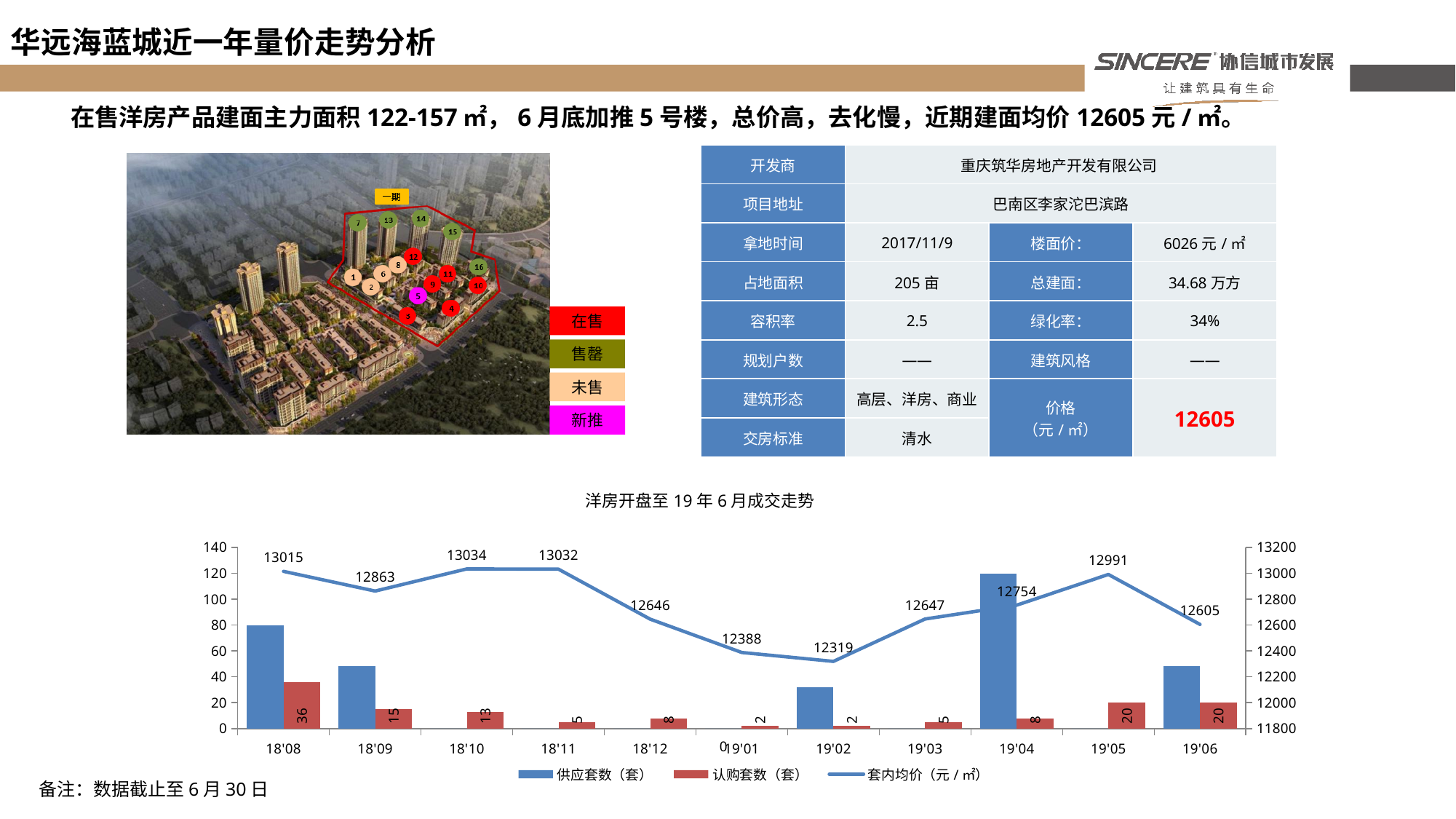
How many months are shown on the x axis of the chart? 11 Does the 套内均价（元/㎡） rise or fall from 19'02 to 19'05? rise How many series does the chart legend list? 3 Is the 供应套数（套） value for 19'04 greater or less than 100? greater Which month has a larger 认购套数（套）, 18'09 or 18'10? 18'09 Is the 供应套数（套） value for 18'08 greater or less than 60? greater What is the 认购套数（套） value for 19'05? 20 In which month is the 套内均价（元/㎡） highest? 18'10 What is the difference between the 套内均价（元/㎡） for 18'08 and for 19'06? 410 Which month has the highest 认购套数（套）? 18'08 What is the 套内均价（元/㎡） value for 18'08? 13015 In which month is the 套内均价（元/㎡） lowest? 19'02